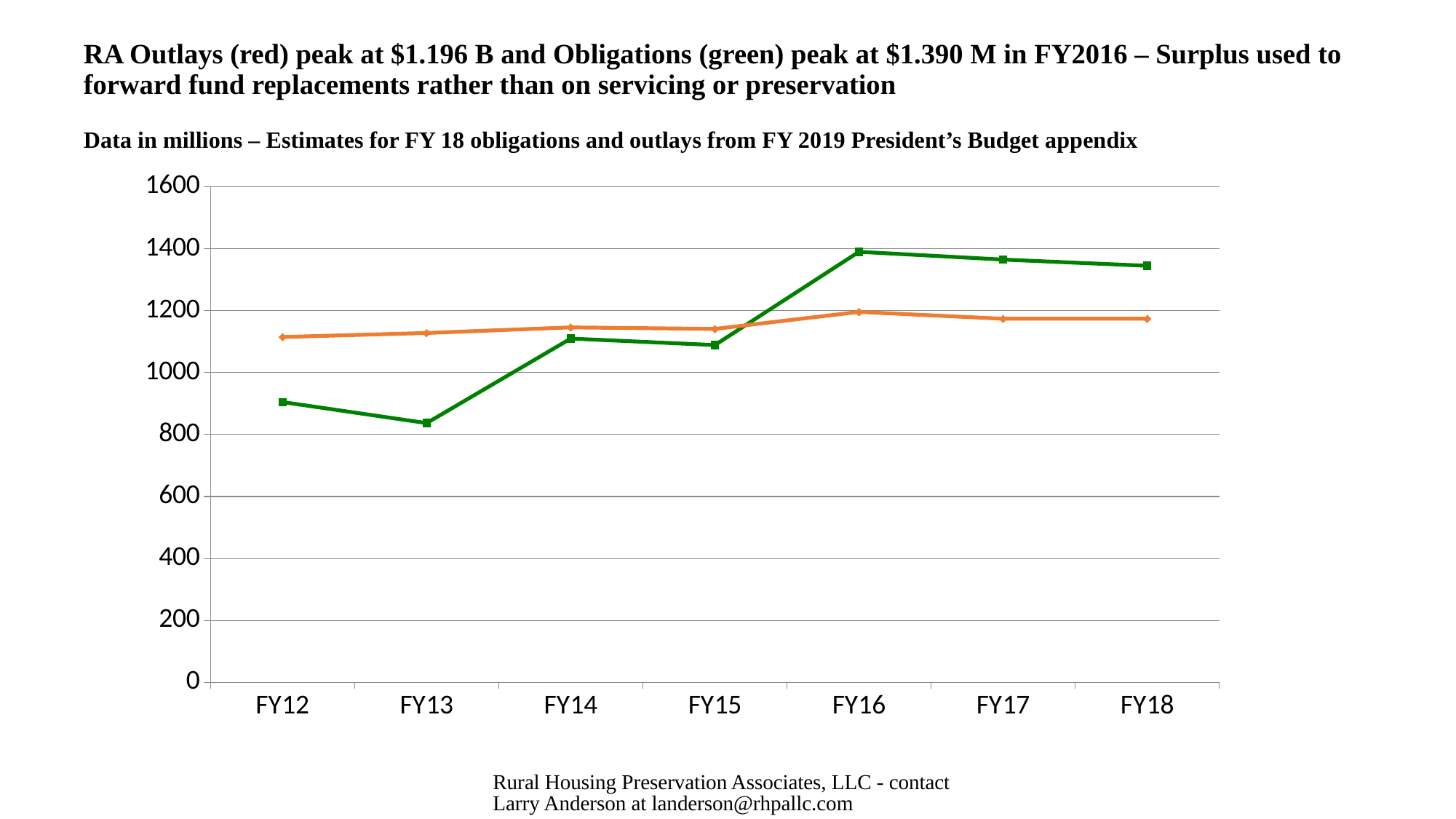
Is the green (Obligations) value for FY17 greater or less than 1400? less Which fiscal year has the highest value on the green (Obligations) line? FY16 In FY12, which line is higher, the green (Obligations) line or the orange (Outlays) line? orange (Outlays) Is the orange (Outlays) value for FY12 greater or less than 1000? greater How many fiscal years are plotted along the x axis? 7 Does the green (Obligations) line rise or fall from FY16 to FY18? fall In FY16, which line is higher, the green (Obligations) line or the orange (Outlays) line? green (Obligations) According to the slide title, at what value do Obligations (green) peak in FY2016? $1.390 M What kind of chart is shown on the slide? line chart Is the green (Obligations) value for FY13 greater or less than 800? greater Which fiscal year has the lowest value on the green (Obligations) line? FY13